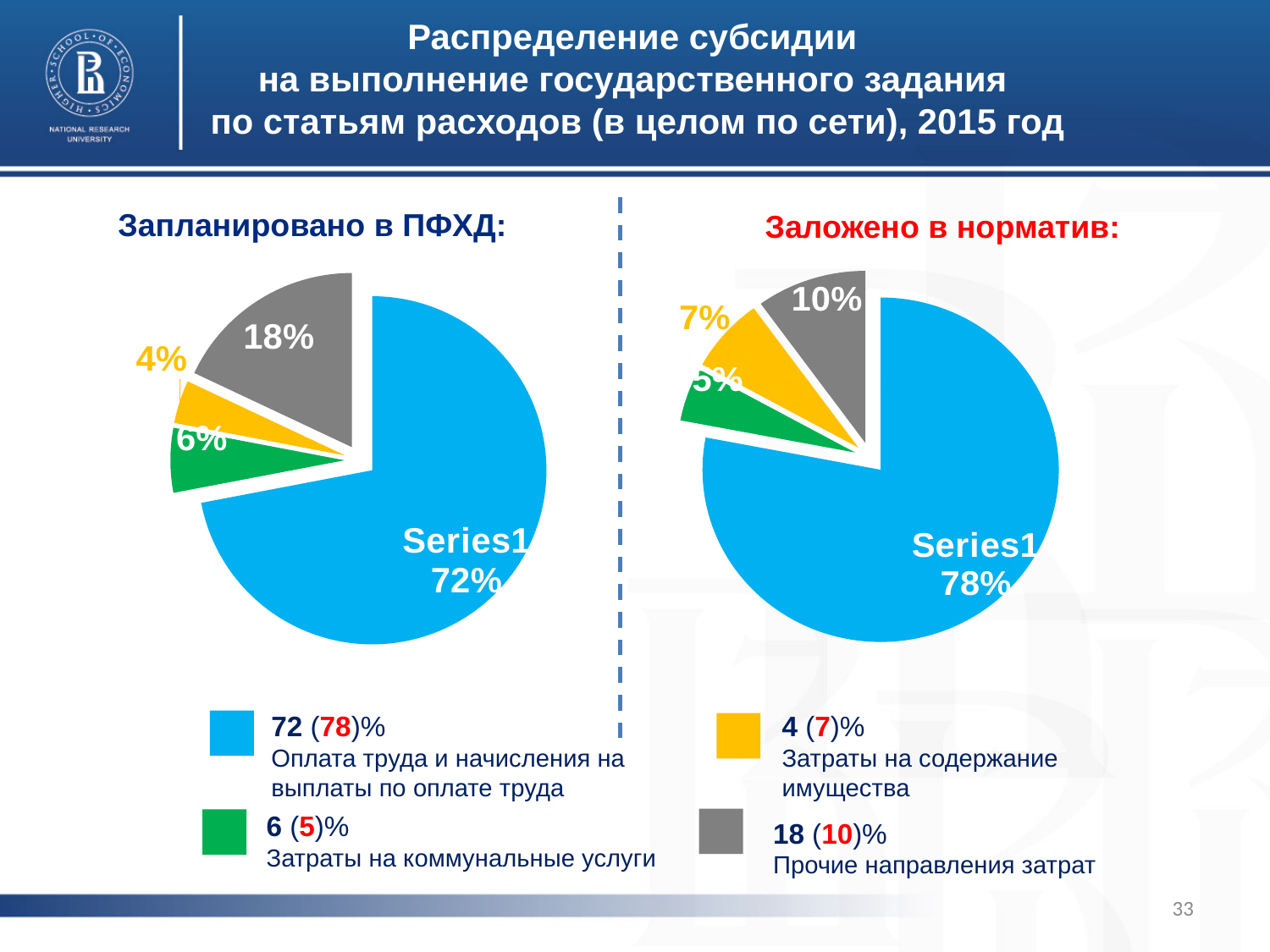
What is the difference between the share for Прочие направления затрат in the left chart (18%) and in the right chart (10%)? 8% In the right pie chart (Заложено в норматив), what share is labelled for Затраты на содержание имущества? 7% What type of chart is used on this slide? pie chart In the left pie chart (Запланировано в ПФХД), what share is labelled for Оплата труда и начисления на выплаты по оплате труда? 72% In the left pie chart (Запланировано в ПФХД), which category has the largest slice? Оплата труда и начисления на выплаты по оплате труда In the left pie chart (Запланировано в ПФХД), what share is labelled for Прочие направления затрат? 18% In the left pie chart (Запланировано в ПФХД), what share is labelled for Затраты на коммунальные услуги? 6% In the right pie chart (Заложено в норматив), which category has the smallest slice? Затраты на коммунальные услуги How many slices does the left pie chart (Запланировано в ПФХД) have? 4 Which chart shows a larger share for Затраты на содержание имущества, the left (Запланировано в ПФХД) or the right (Заложено в норматив)? the right (Заложено в норматив) What colour represents Затраты на коммунальные услуги in the pie charts? green In the right pie chart (Заложено в норматив), what share is labelled for Оплата труда и начисления на выплаты по оплате труда? 78%